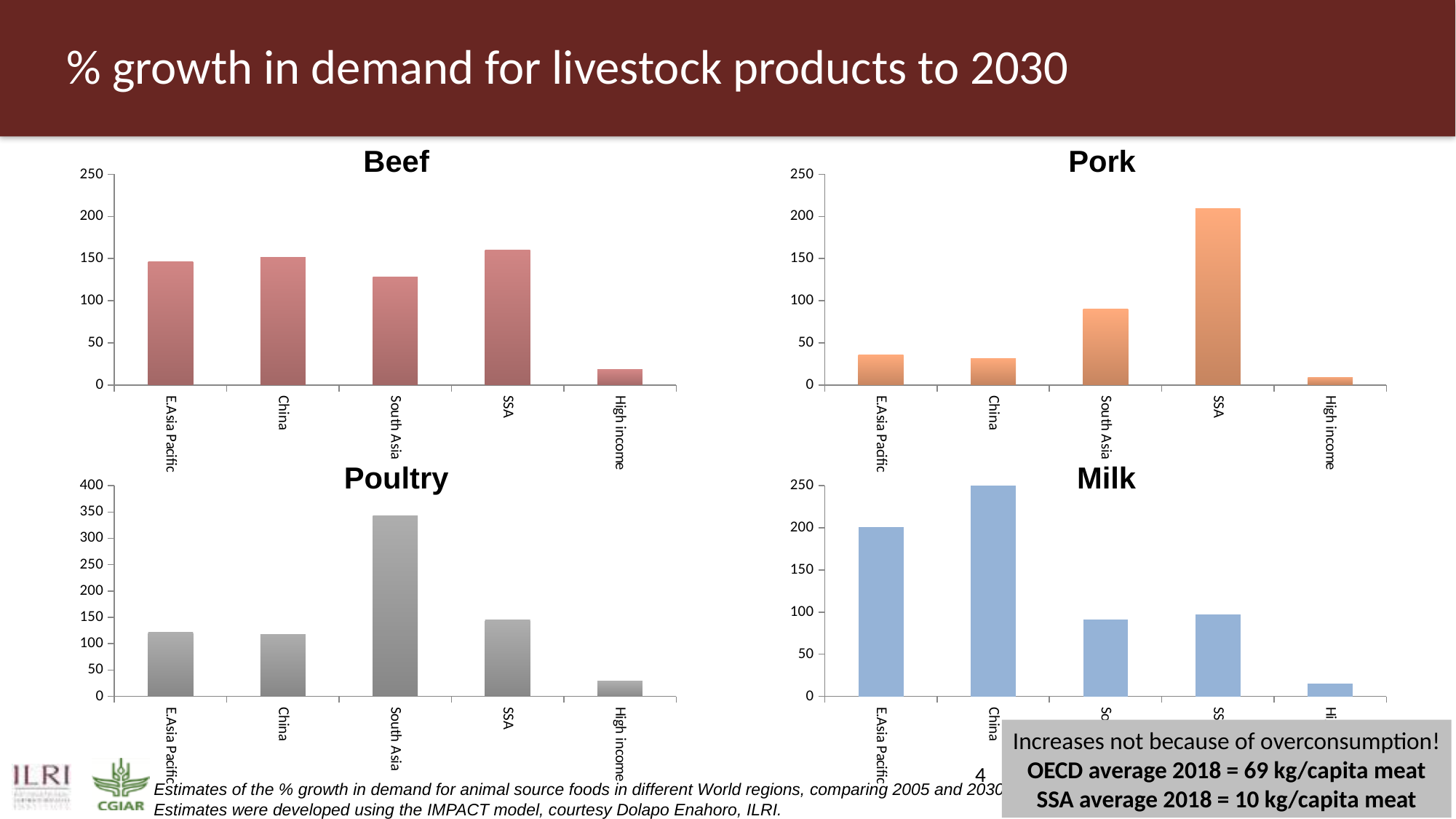
In the Beef chart, which region has the lowest value? High income In the Poultry chart, which region has the lowest value? High income In the Pork chart, is the value for SSA greater or less than 200? greater In the Pork chart, which region has the highest value? SSA In the Pork chart, which is larger, the value for China or the value for South Asia? South Asia What kind of chart is the Beef chart? bar chart In the Milk chart, which region has the highest value? China In the Milk chart, is the value for E.Asia Pacific greater or less than 150? greater In the Beef chart, which is larger, the value for South Asia or the value for SSA? SSA How many regions are shown on the x axis of the Beef chart? 5 In the Poultry chart, which region has the highest value? South Asia In the Poultry chart, is the value for South Asia greater or less than 300? greater